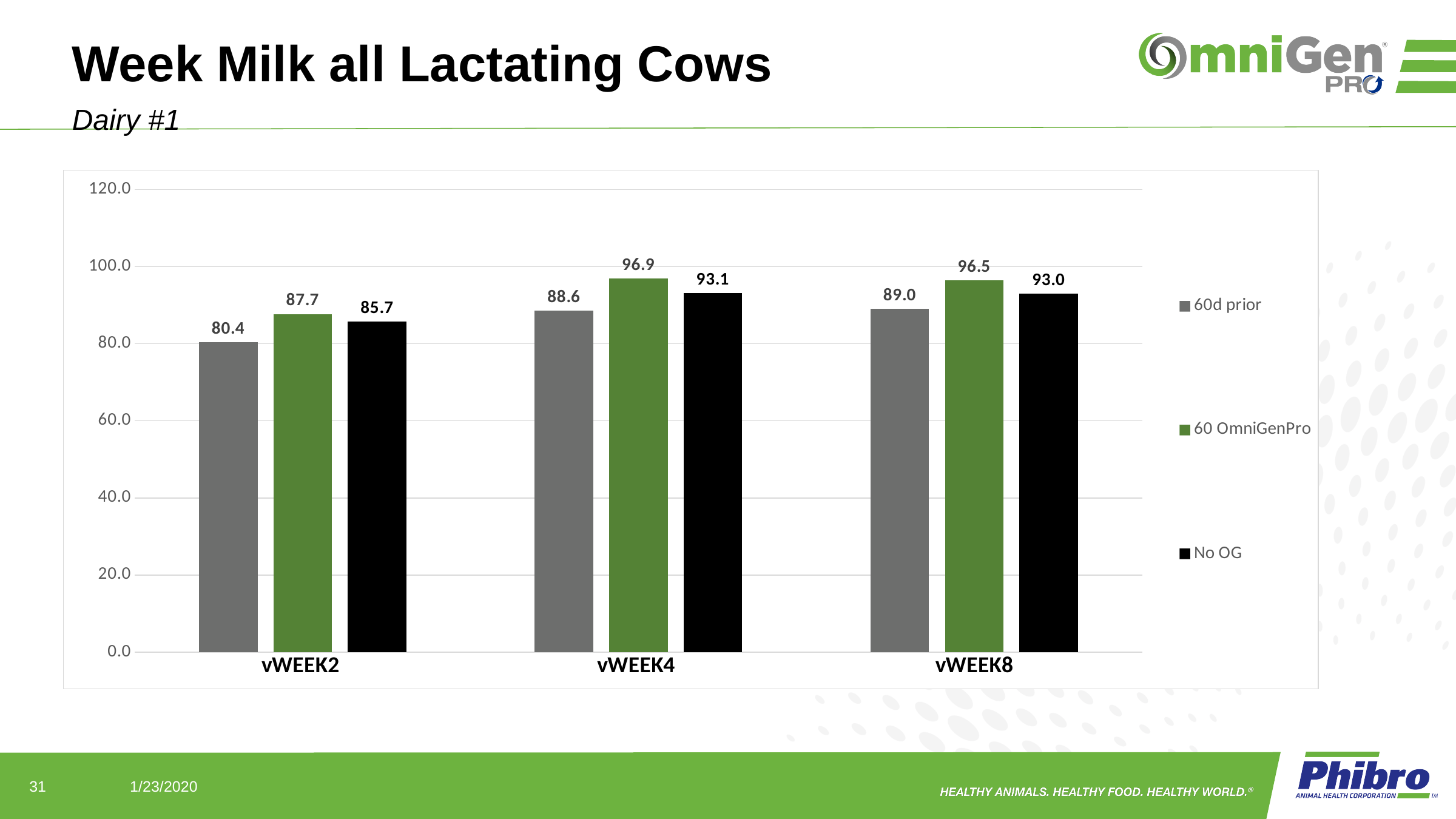
Which is larger at vWEEK4: 60d prior or No OG? No OG What is the value for No OG at vWEEK8? 93.0 Which series is shown in green in the legend? 60 OmniGenPro Which category has the lowest value for the 60d prior series? vWEEK2 What kind of chart is shown on the slide? bar chart How many categories are shown on the x axis? 3 What is the difference between 60 OmniGenPro and 60d prior at vWEEK8? 7.5 What is the value for 60 OmniGenPro at vWEEK4? 96.9 Which category has the highest value for the 60 OmniGenPro series? vWEEK4 How many series does the legend list? 3 What is the value for 60d prior at vWEEK2? 80.4 What is the difference between 60 OmniGenPro and No OG at vWEEK2? 2.0